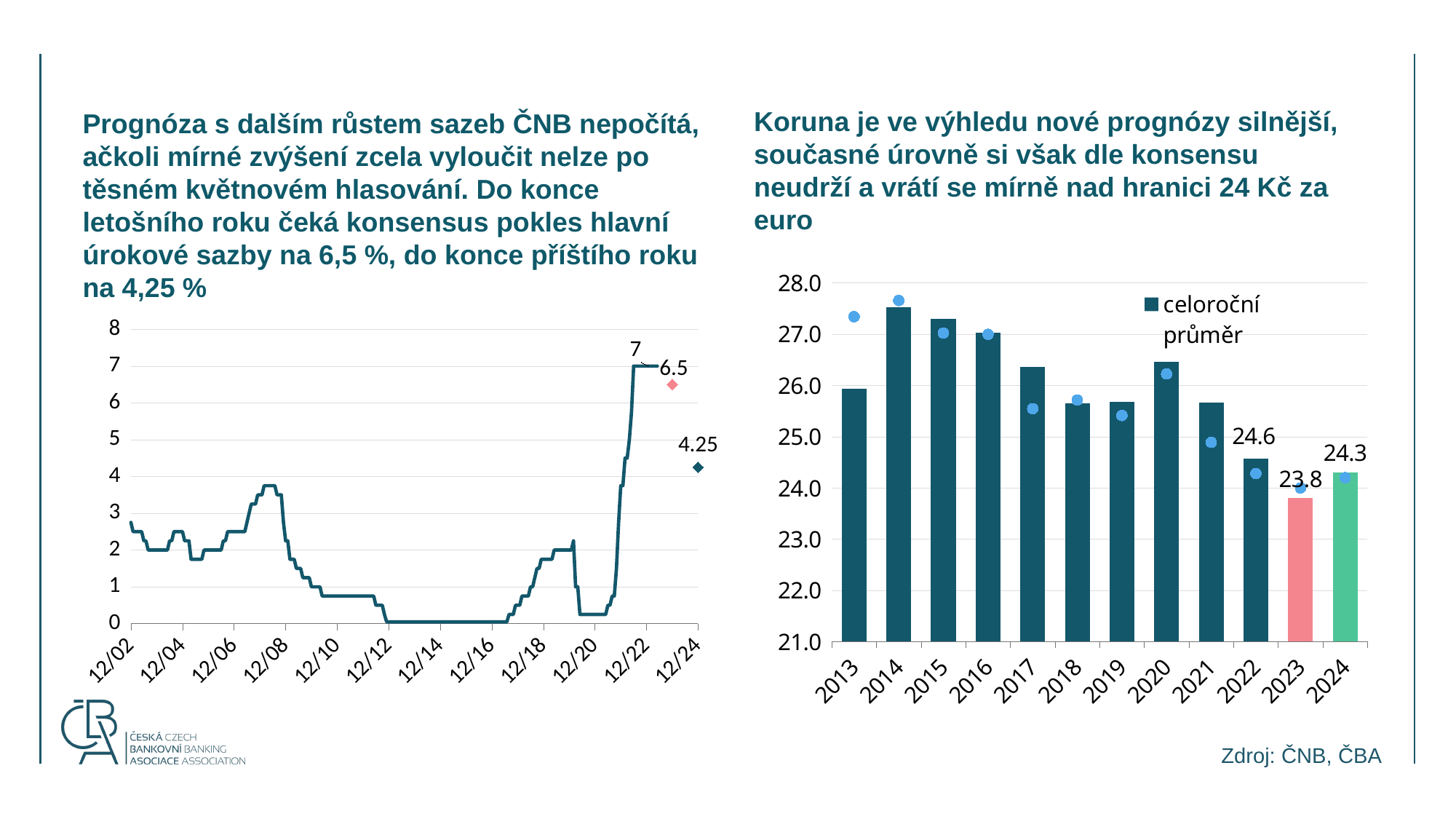
On the left chart, what is the value of the lower diamond marker labelled near 12/24? 4.25 On the left chart, what is the value of the upper diamond marker labelled after the end of the line? 6.5 On the right chart, what is the difference between the bars for 2022 and 2023? 0.8 What kind of chart is the left chart? line chart On the right chart, which year has the lowest bar? 2023 On the left chart, is the value at 12/14 greater or less than 1? less On the left chart, what value is labelled at the end of the line around 12/22? 7 On the left chart, does the line rise or fall between 12/20 and 12/22? rise How many bars are shown on the right chart? 12 On the right chart, is the bar for 2020 greater or less than 26.0? greater On the right chart, what is the value of the bar for 2024? 24.3 On the right chart, what is the value of the bar for 2023? 23.8